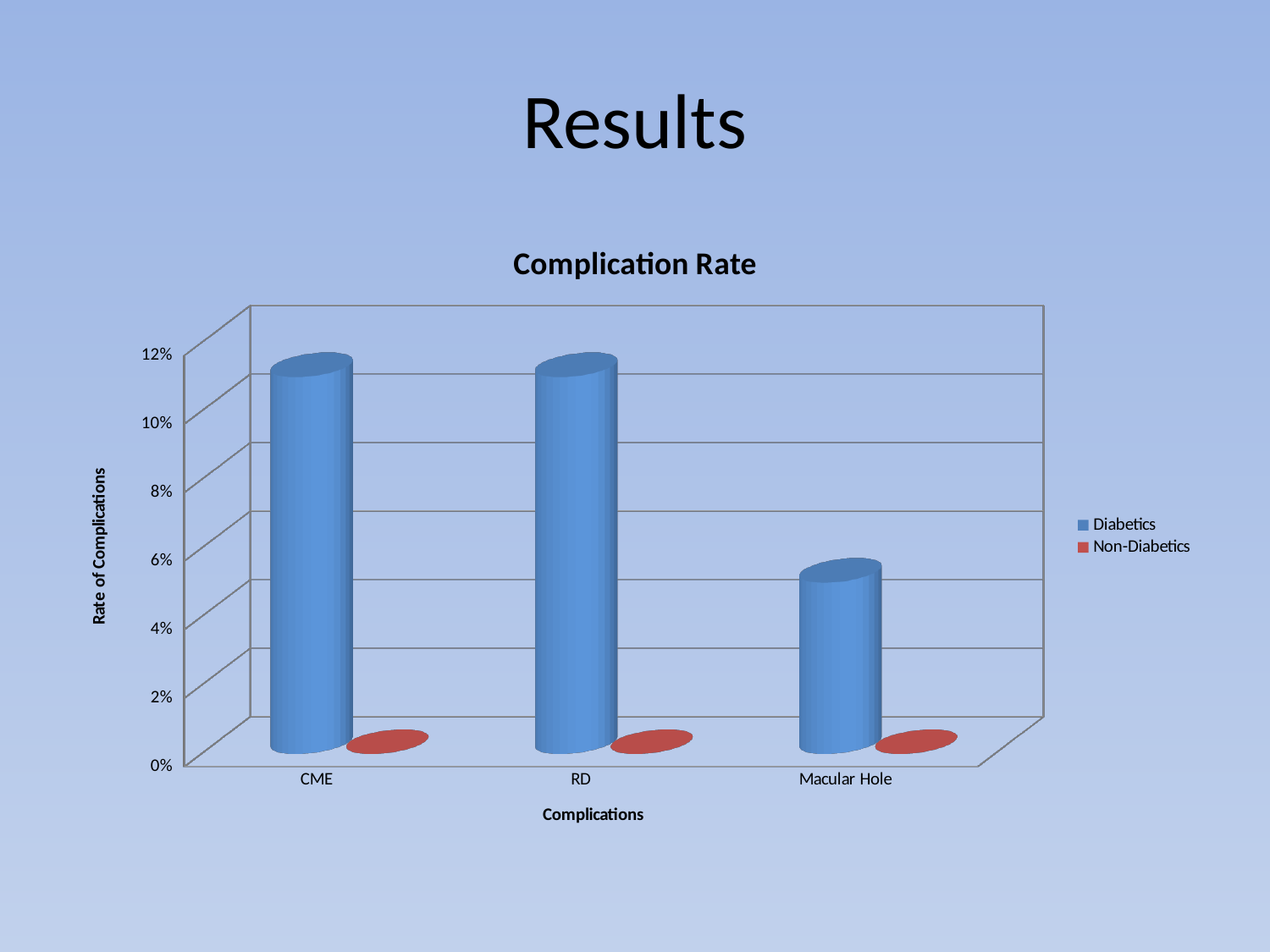
What type of chart is shown on the slide? bar chart Is the Diabetics value for Macular Hole greater or less than 4%? greater Is the Diabetics value for Macular Hole greater or less than 6%? less Which complication has the lowest rate for Diabetics? Macular Hole Is the Diabetics value for CME greater or less than 10%? greater How many complication categories are shown on the x axis? 3 What is the title of the chart? Complication Rate What is the label of the y axis? Rate of Complications How many series does the legend list? 2 For Diabetics, which is larger: the value for CME or the value for Macular Hole? CME